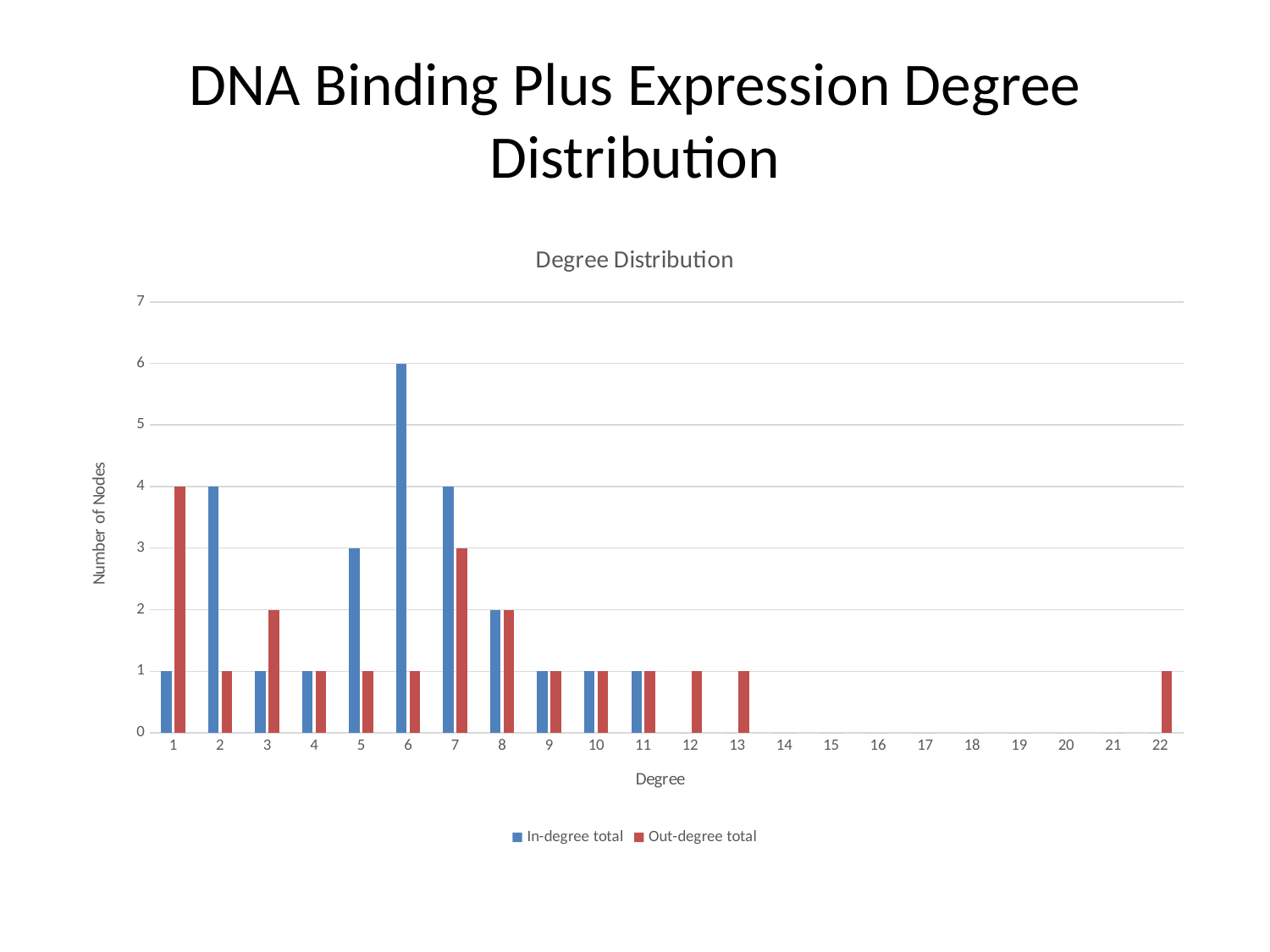
What kind of chart is shown on the slide? bar chart Which degree has the highest In-degree total? 6 What is the In-degree total for degree 5? 3 At degree 2, which is larger, the In-degree total or the Out-degree total? In-degree total What is the difference between the In-degree total and the Out-degree total at degree 6? 5 What is the Out-degree total for degree 1? 4 What is the In-degree total for degree 6? 6 How many degree categories are shown on the x axis? 22 Which degree has the highest Out-degree total? 1 What is the title of the chart? Degree Distribution How many series does the legend list? 2 What is the Out-degree total for degree 7? 3